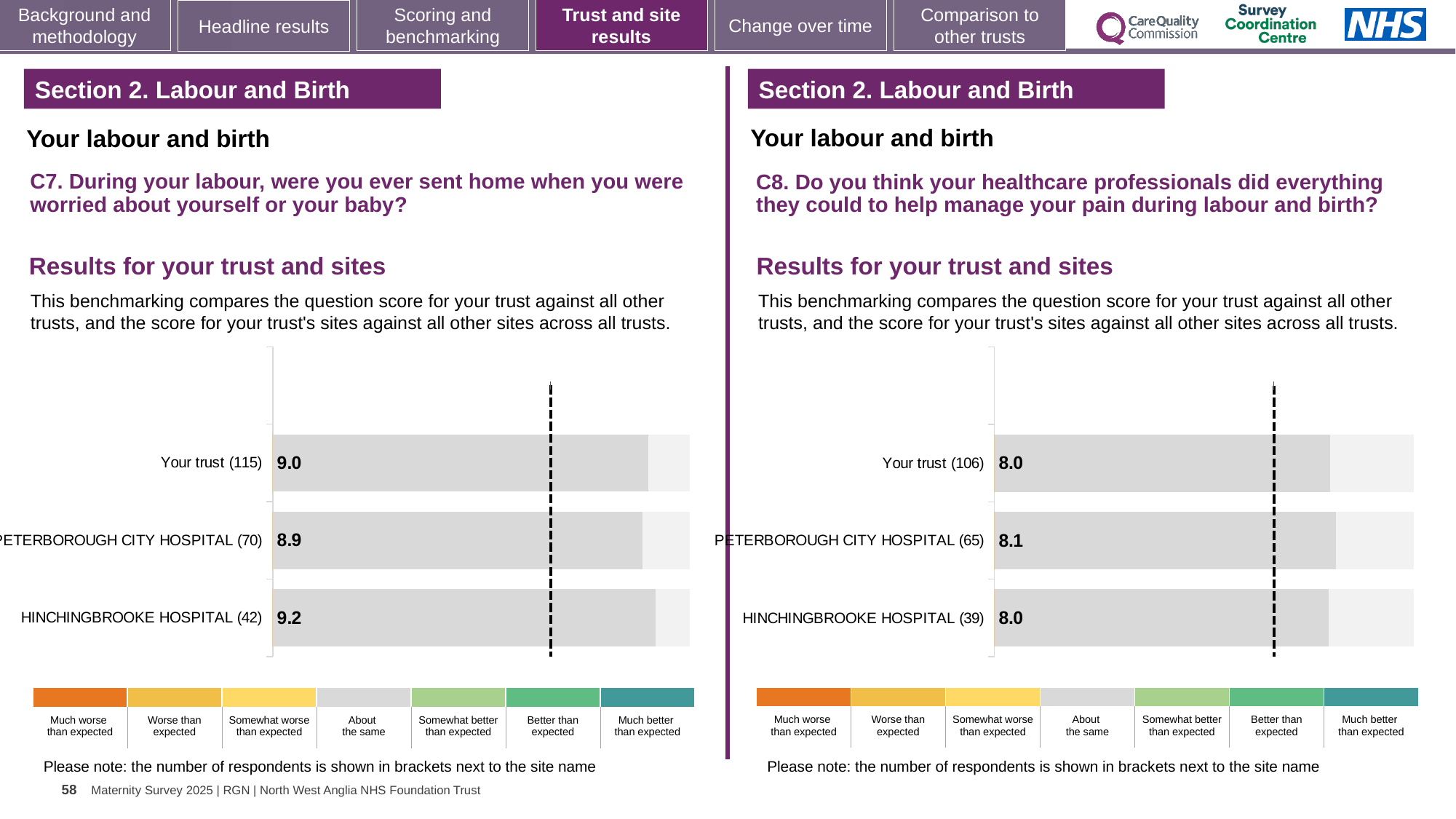
On the C7 chart (left), what is the score for HINCHINGBROOKE HOSPITAL? 9.2 On the C7 chart (left), how many respondents are shown in brackets for Your trust? 115 On the C8 chart (right), which site or trust has the highest score? PETERBOROUGH CITY HOSPITAL On the C7 chart (left), how many bars are plotted? 3 What kind of chart is used on the C8 chart (right)? Bar chart On the C7 chart (left), what is the score for Your trust? 9.0 On the C8 chart (right), what is the score for Your trust? 8.0 On the C8 chart (right), what is the score for PETERBOROUGH CITY HOSPITAL? 8.1 On the C7 chart (left), which site or trust has the highest score? HINCHINGBROOKE HOSPITAL On the C8 chart (right), how many respondents are shown in brackets for HINCHINGBROOKE HOSPITAL? 39 On the C7 chart (left), what is the difference between the scores for HINCHINGBROOKE HOSPITAL and PETERBOROUGH CITY HOSPITAL? 0.3 On the C7 chart (left), which site or trust has the lowest score? PETERBOROUGH CITY HOSPITAL